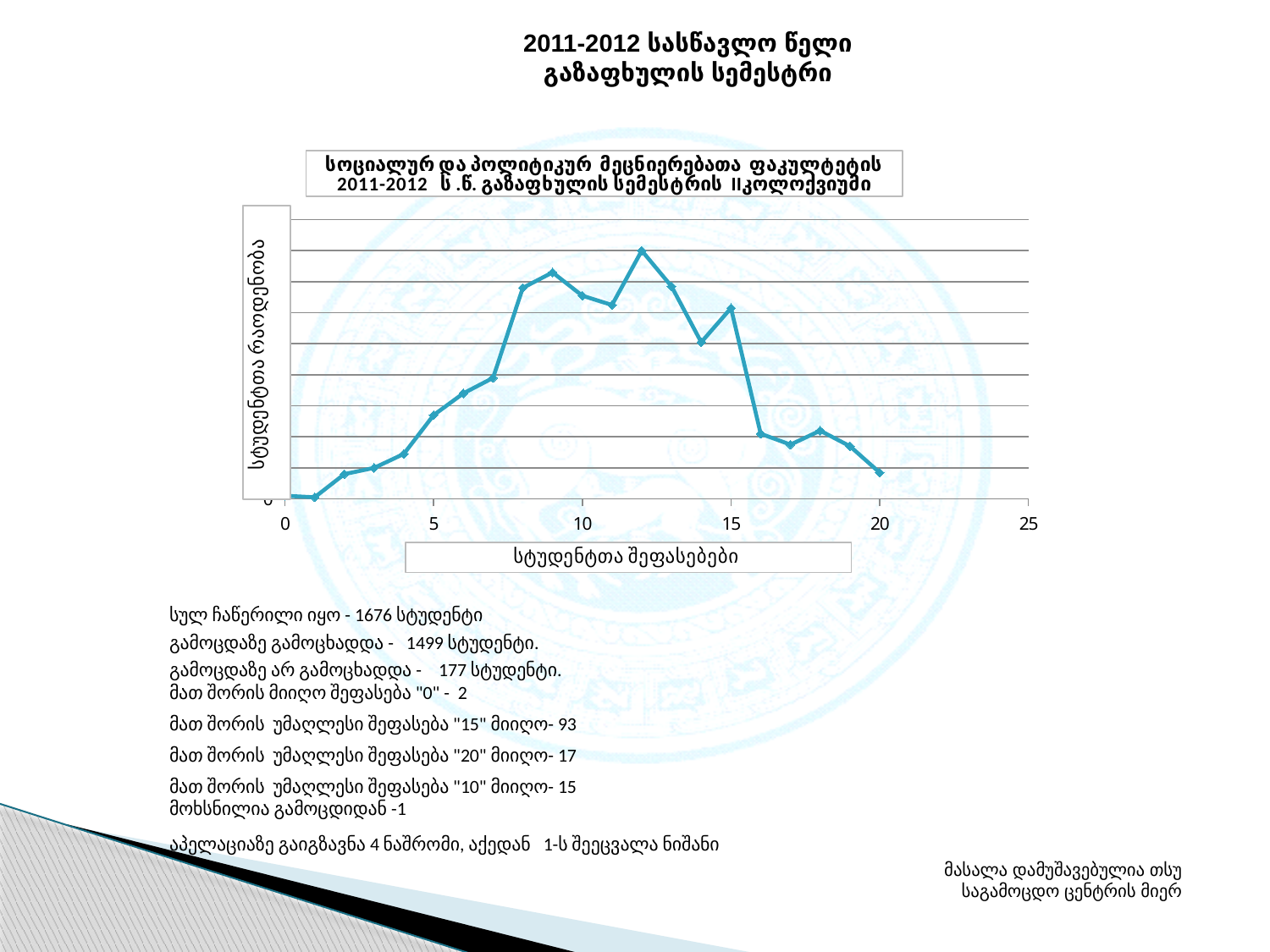
At which x-axis value (grade) does the line reach its highest point? 12 What is the highest tick label shown on the x axis? 25 Is the value at x = 12 larger or smaller than the value at x = 9? larger Does the line generally rise or fall between x = 0 and x = 12? rise Does the line generally rise or fall between x = 15 and x = 20? fall Which has the larger value: x = 2 or x = 18? 18 How many data points are plotted on the line? 21 Which has the larger value: x = 5 or x = 15? 15 What kind of chart is shown on the slide? line chart What is the label of the x axis? სტუდენტთა შეფასებები